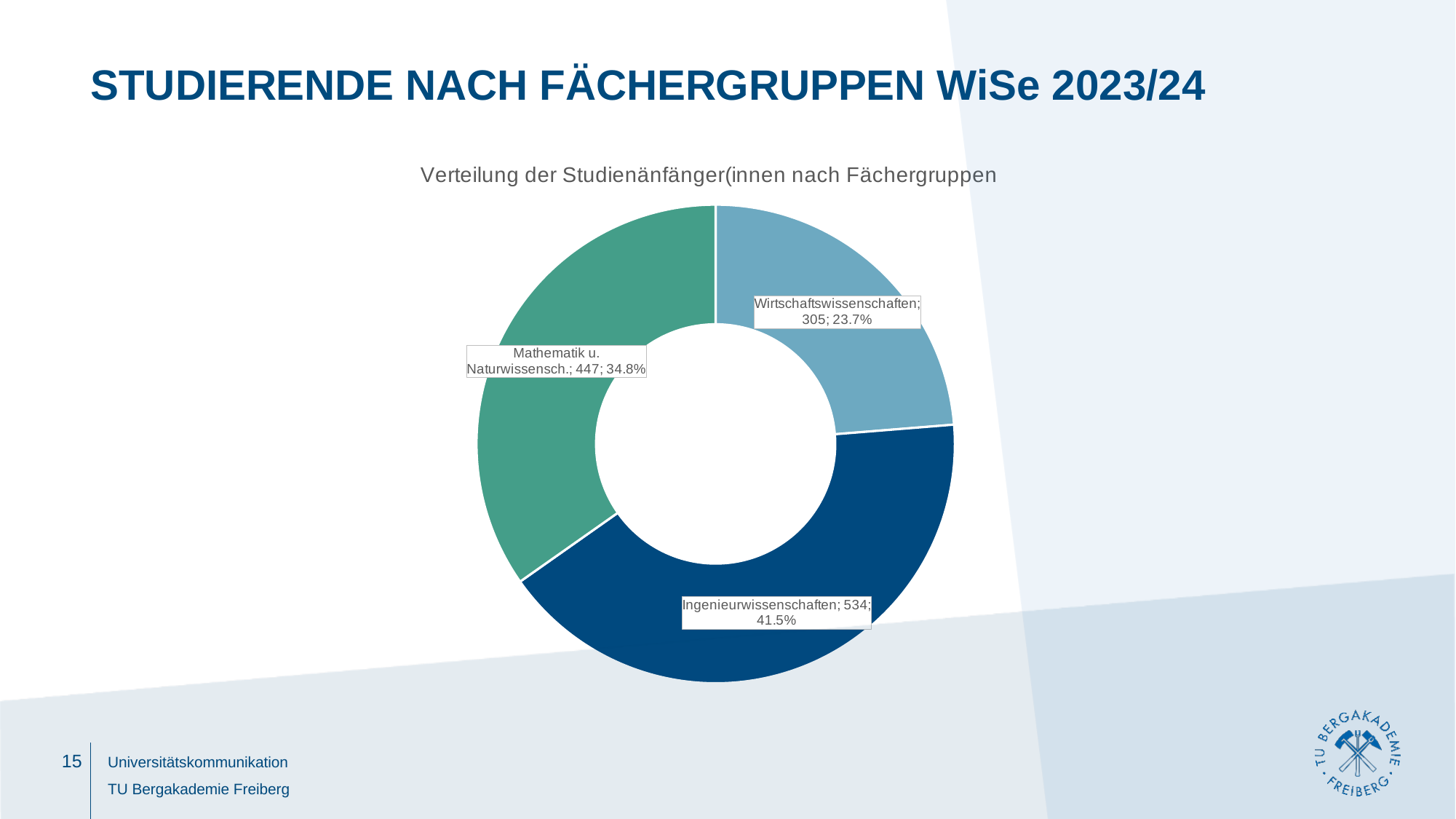
What is the title of the chart? Verteilung der Studienänfänger(innen nach Fächergruppen What is the difference between the values for Mathematik u. Naturwissensch. and Wirtschaftswissenschaften? 142 How many subject groups are shown in the chart? 3 What kind of chart is shown on the slide? Doughnut (pie) chart What is the value for Mathematik u. Naturwissensch.? 447 What is the difference in student numbers between Ingenieurwissenschaften and Wirtschaftswissenschaften? 229 What share of the chart does Wirtschaftswissenschaften represent? 23.7% Which is larger, the value for Mathematik u. Naturwissensch. or for Ingenieurwissenschaften? Ingenieurwissenschaften Which subject group has the largest share? Ingenieurwissenschaften What percentage share does Mathematik u. Naturwissensch. have? 34.8% Which subject group has the smallest share? Wirtschaftswissenschaften How many students are in the Ingenieurwissenschaften group? 534